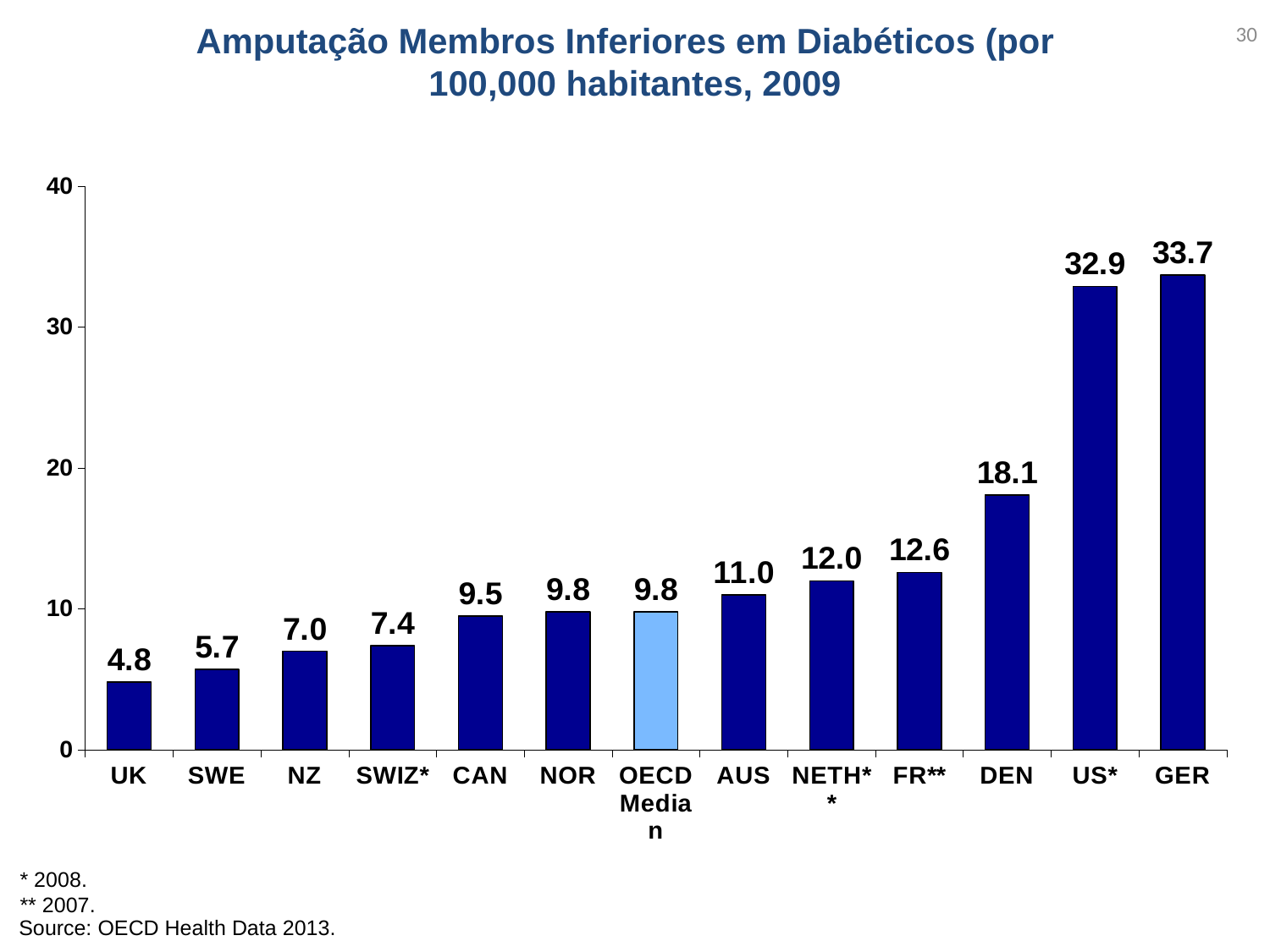
Which bar is shown in a lighter blue colour than the others? OECD Median What is the value for DEN? 18.1 What is the difference between the values for GER and US*? 0.8 What is the value for the OECD Median? 9.8 Is the value for DEN greater or less than 20? less What is the value for UK? 4.8 Which is larger, the value for FR** or the value for NETH**? FR** Which category has the highest value? GER Do the values generally rise or fall from left to right along the x axis? rise What kind of chart is this? bar chart Which category has the lowest value? UK How many categories are shown on the x axis? 13